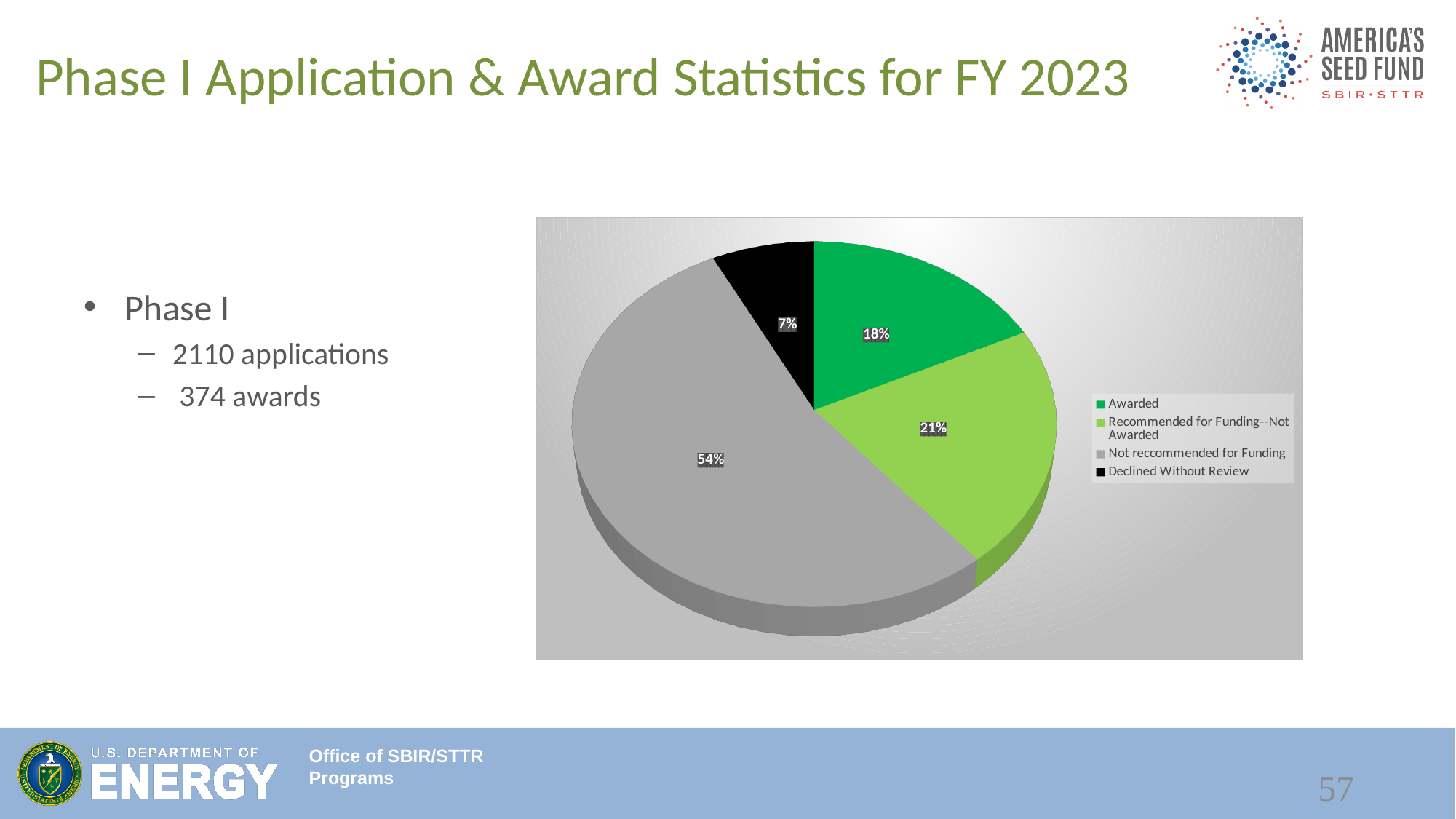
Which category has the smallest slice of the pie? Declined Without Review What is the difference in percentage points between the Not reccommended for Funding slice and the Awarded slice? 36 What share of the pie is labelled Declined Without Review? 7% What kind of chart is shown on the slide? Pie chart What share of the pie is labelled Awarded? 18% What share of the pie is labelled Recommended for Funding--Not Awarded? 21% What colour is the Declined Without Review slice? Black Which category has the largest slice of the pie? Not reccommended for Funding Which slice is larger: Awarded or Recommended for Funding--Not Awarded? Recommended for Funding--Not Awarded What is the difference in percentage points between the Recommended for Funding--Not Awarded slice and the Declined Without Review slice? 14 How many categories does the pie chart show? 4